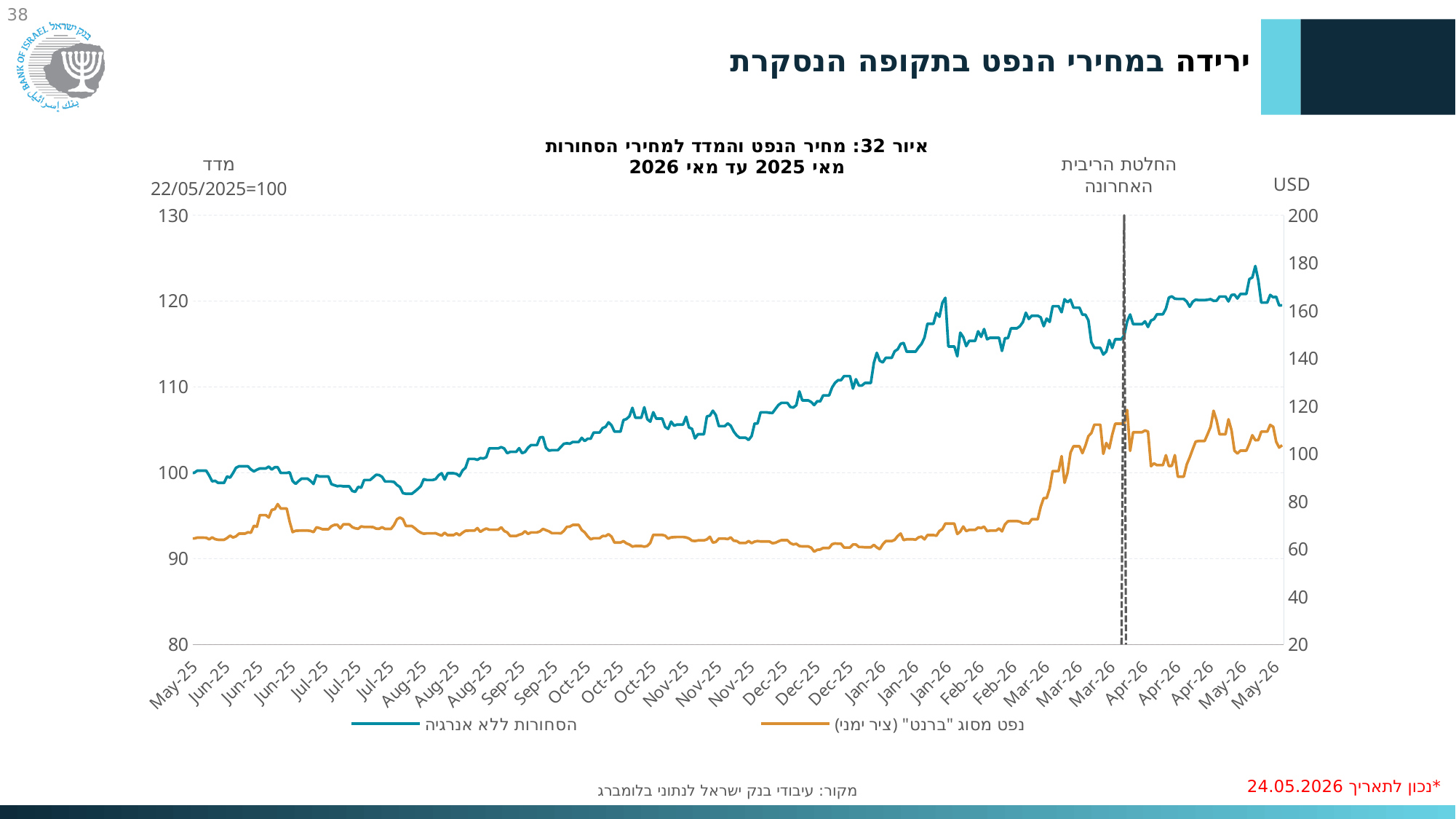
What kind of chart is shown on the slide? line chart Does the Brent oil series rise or fall from its peak in Apr-26 to the end of the period in May-26? fall What is the highest tick value shown on the right (USD) axis? 200 What is the base date of the commodities index shown on the left axis? 22/05/2025=100 Is the value of the Brent oil series (right axis) in Dec-25 greater or less than 80 USD? less How many series does the legend list? 2 Is the value of the Brent oil series (right axis) at the start of the period, May-25, greater or less than 80 USD? less Is the value of the Brent oil series (right axis) at its peak in Apr-26 greater or less than 100 USD? greater Which series is plotted on the right axis (ציר ימני)? נפט מסוג "ברנט" Does the non-energy commodities index (הסחורות ללא אנרגיה) rise or fall overall from May-25 to May-26? rise